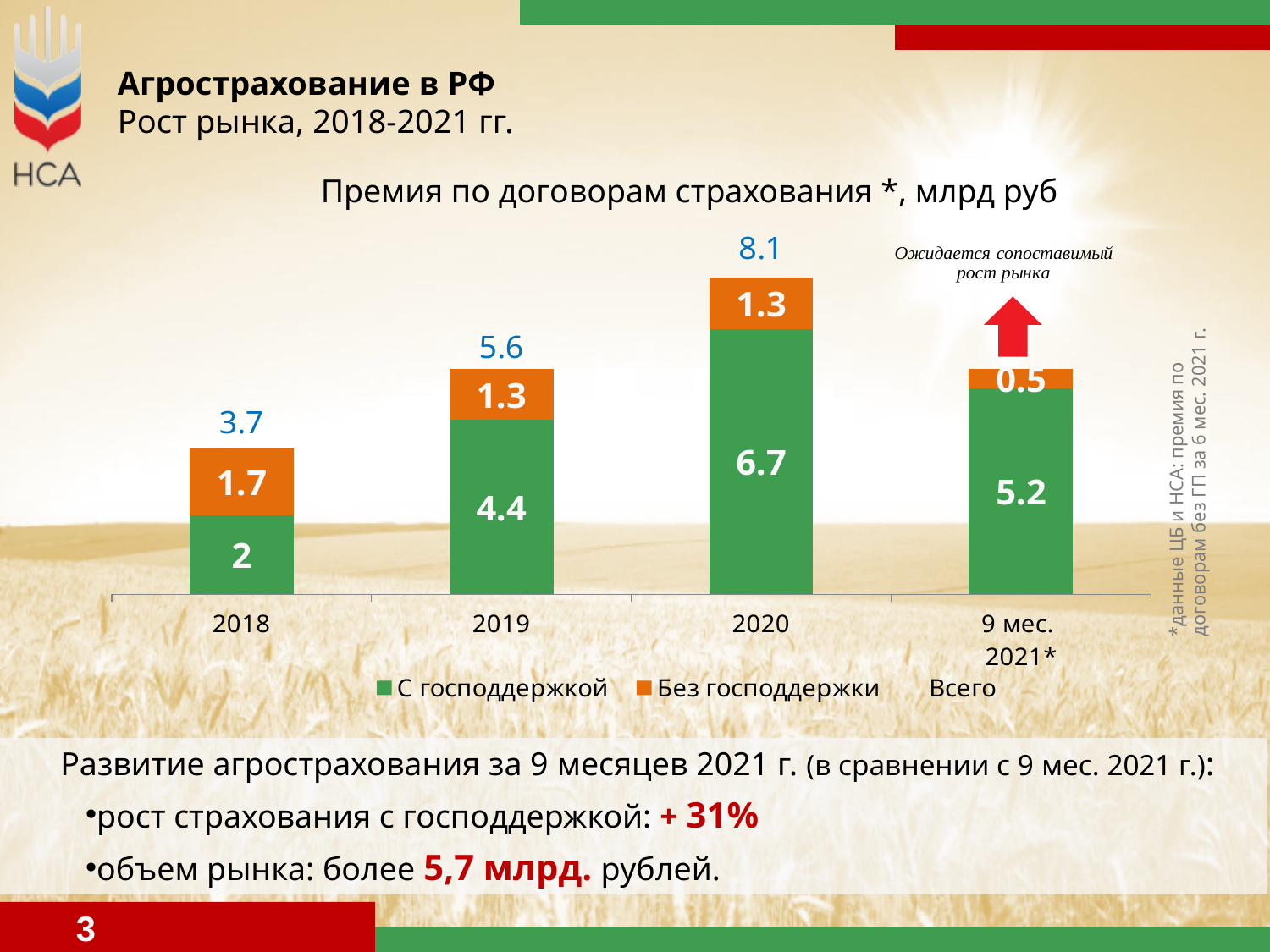
What is the total of the stacked bar for 9 мес. 2021* (5.2 + 0.5)? 5.7 How many categories are shown on the x axis? 4 Which year has the highest total premium? 2020 What is the value for 'Без господдержки' in 2018? 1.7 Which is larger: the 'С господдержкой' value in 2018 or in 2019? 2019 What is the difference between the 'С господдержкой' values for 2020 and 2019? 2.3 What is the value for 'С господдержкой' for 9 мес. 2021*? 5.2 What kind of chart is shown on the slide? Stacked bar chart What is the value for 'С господдержкой' in 2020? 6.7 Which category has the lowest value for 'Без господдержки'? 9 мес. 2021* What is the total ('Всего') shown above the bar for 2019? 5.6 How many series does the legend list? 3